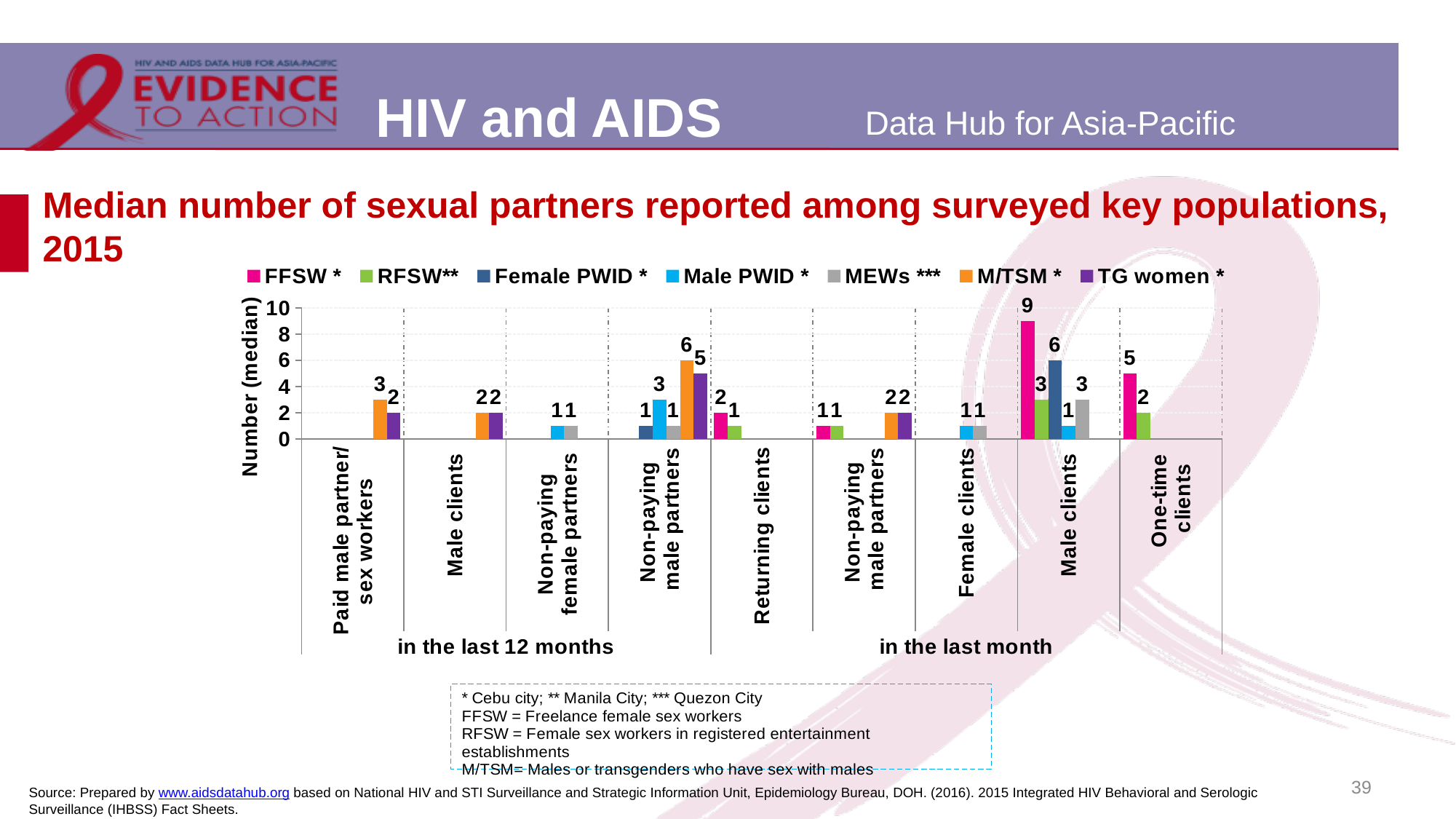
What is the title of the vertical axis? Number (median) What is the MEWs value for male clients in the last month? 3 How many series does the legend list? 7 What is the median number of male clients in the last month for FFSW? 9 Which series and category has the highest value in the chart? FFSW, Male clients in the last month What kind of chart is shown on the slide? bar chart For Male PWID, which is larger: non-paying male partners in the last 12 months or male clients in the last month? non-paying male partners in the last 12 months What is the value for Female PWID for male clients in the last month? 6 What is the difference between the FFSW and RFSW values for one-time clients in the last month? 3 What is the value for M/TSM for paid male partner/sex workers in the last 12 months? 3 What is the TG women value for paid male partner/sex workers in the last 12 months? 2